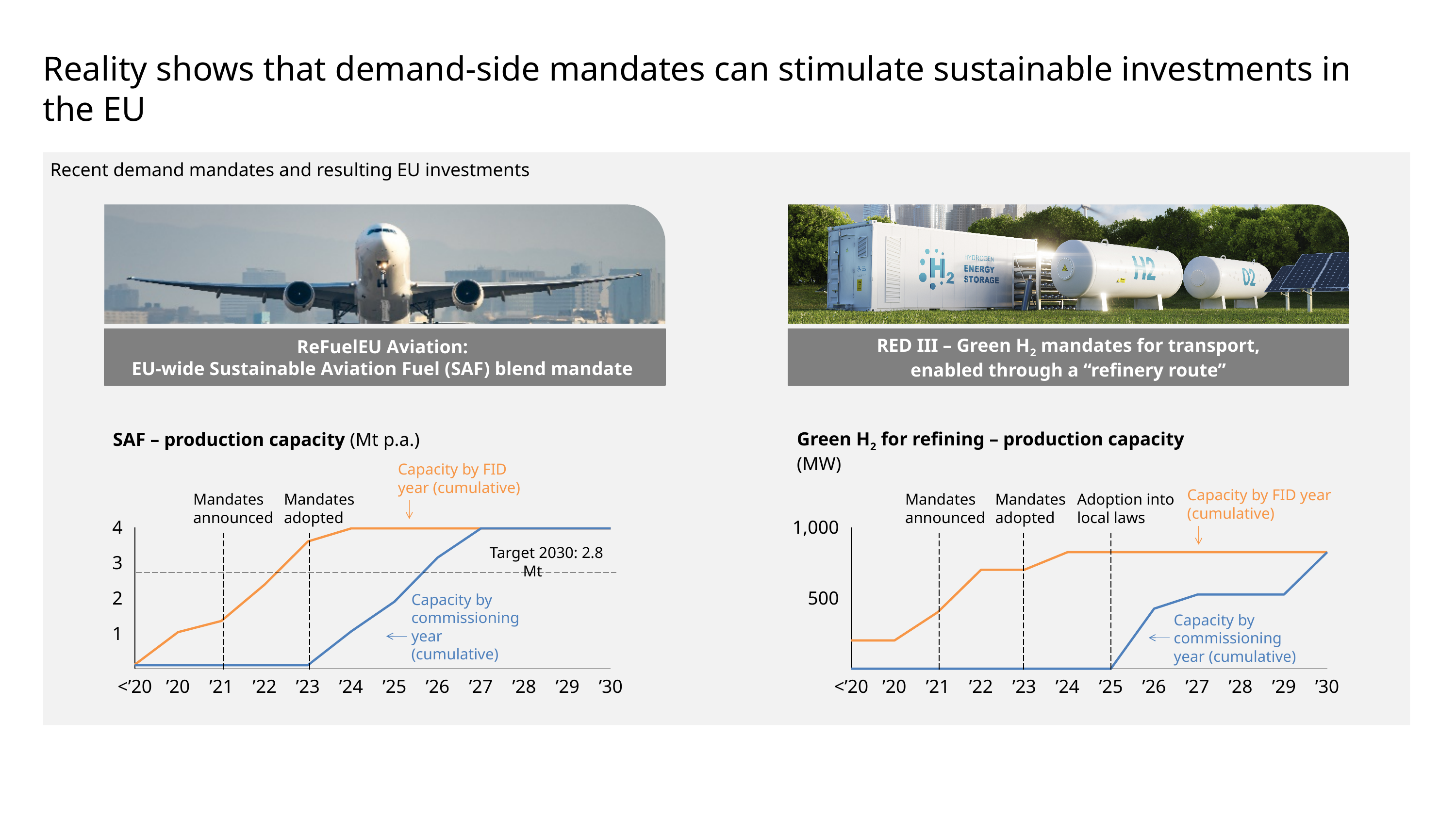
On the 'Green H2 for refining – production capacity' chart, is the 'Capacity by FID year (cumulative)' value at '22 greater or less than 500? greater On the 'SAF – production capacity' chart, is the 'Capacity by commissioning year (cumulative)' value at '23 greater or less than 1? less On the 'SAF – production capacity' chart, is the 'Capacity by FID year (cumulative)' value at '22 greater or less than 2? greater What unit is given in the title of the 'Green H2 for refining – production capacity' chart? MW On the 'SAF – production capacity' chart, which series is higher at '22: 'Capacity by FID year (cumulative)' or 'Capacity by commissioning year (cumulative)'? Capacity by FID year (cumulative) How many year labels are on the x axis of the 'SAF – production capacity' chart? 12 What kind of chart is the 'SAF – production capacity' chart on the left? line chart On the 'SAF – production capacity' chart, does the 'Capacity by commissioning year (cumulative)' line rise or fall from '23 to '27? rise How many series are plotted on the 'Green H2 for refining – production capacity' chart on the right? 2 On the 'SAF – production capacity' chart, what is the Target 2030 value shown? 2.8 Mt